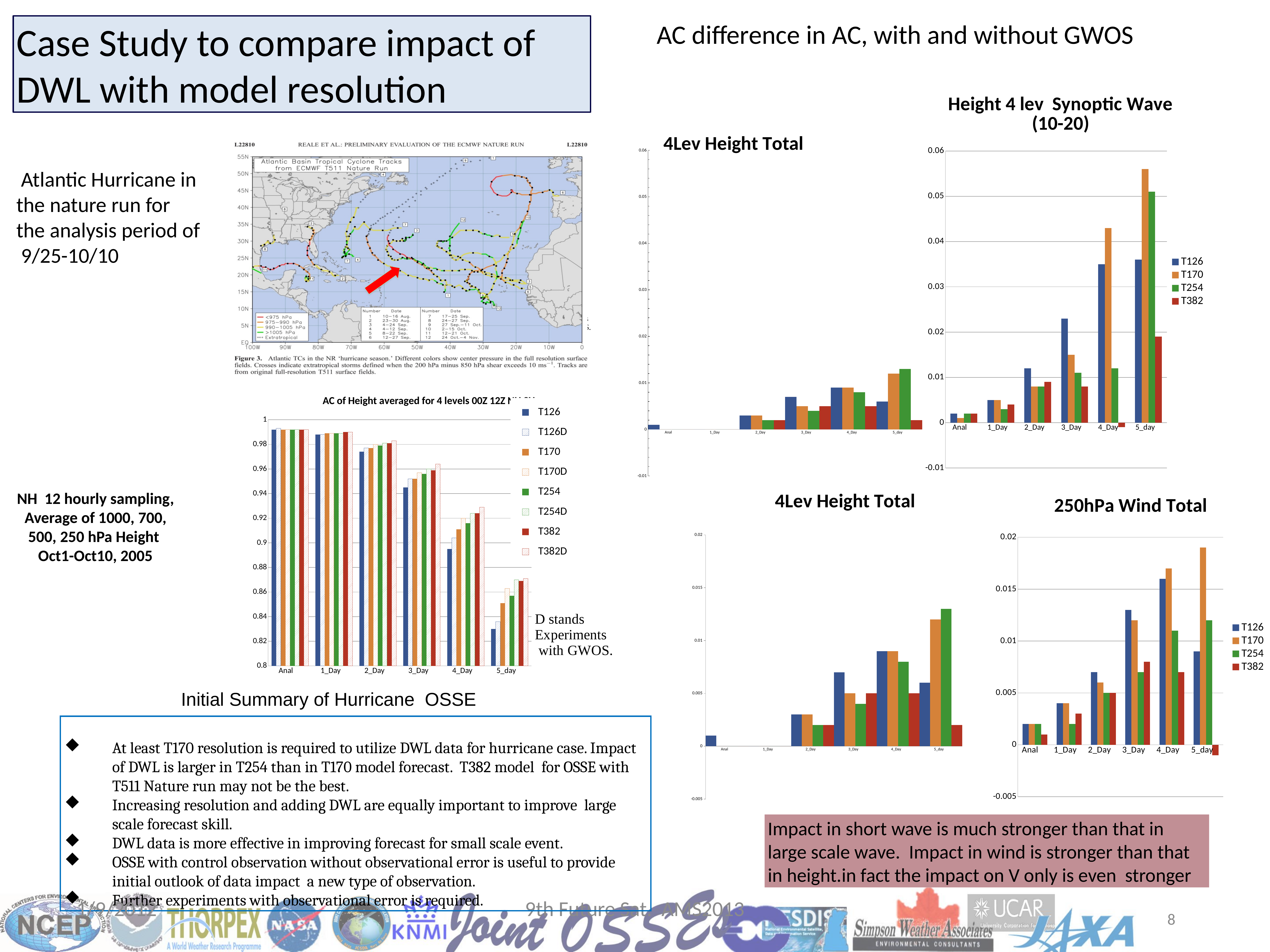
What kind of chart is the '250hPa Wind Total' chart? bar chart In the 'Height 4 lev Synoptic Wave (10-20)' chart, how many series does the legend list? 4 In the '4Lev Height Total' chart at the top middle of the slide, is the tallest bar at 5_day greater or less than 0.01? greater In the 'AC of Height averaged for 4 levels' chart, is the value for T126 at 5_day greater or less than 0.84? less In the '250hPa Wind Total' chart, is the value for T170 at 5_day greater or less than 0.015? greater In the '250hPa Wind Total' chart, which series has the highest value at 5_day? T170 In the 'Height 4 lev Synoptic Wave (10-20)' chart, which series has the highest value at 5_day? T170 In the 'Height 4 lev Synoptic Wave (10-20)' chart, which series has the lowest value at 4_Day? T382 In the '250hPa Wind Total' chart, how many categories are shown on the x axis? 6 In the 'AC of Height averaged for 4 levels' chart, how many series does the legend list? 8 In the 'AC of Height averaged for 4 levels' chart, do the values rise or fall from Anal to 5_day? fall